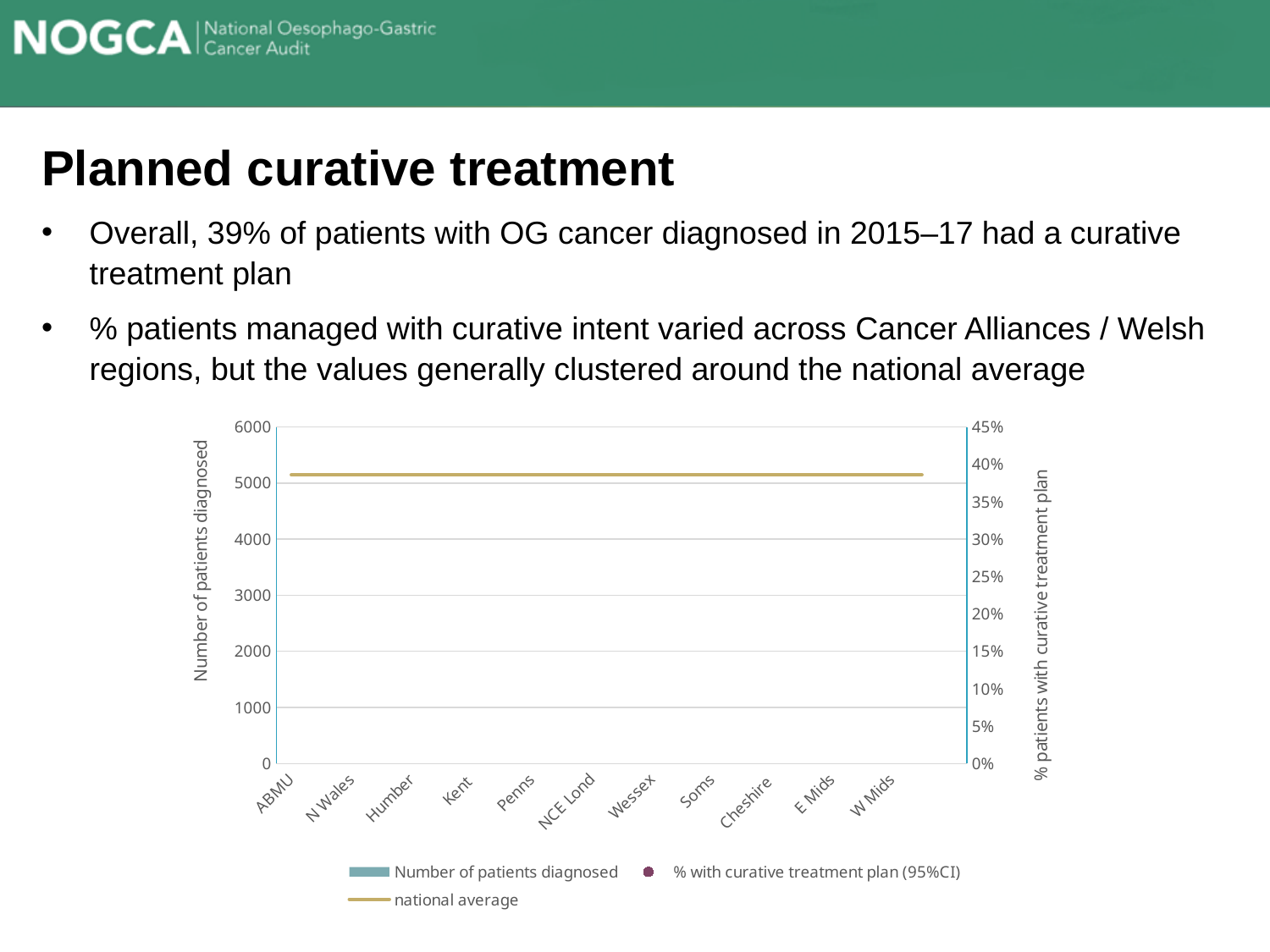
Which legend entry is represented by a line in the chart? national average Is the national average line on the chart greater or less than 30% on the right-hand axis? greater What is the title of the left-hand vertical axis of the chart? Number of patients diagnosed Is the national average line on the chart greater or less than 35% on the right-hand axis? greater How many series does the chart's legend list? 3 What is the title of the right-hand vertical axis of the chart? % patients with curative treatment plan